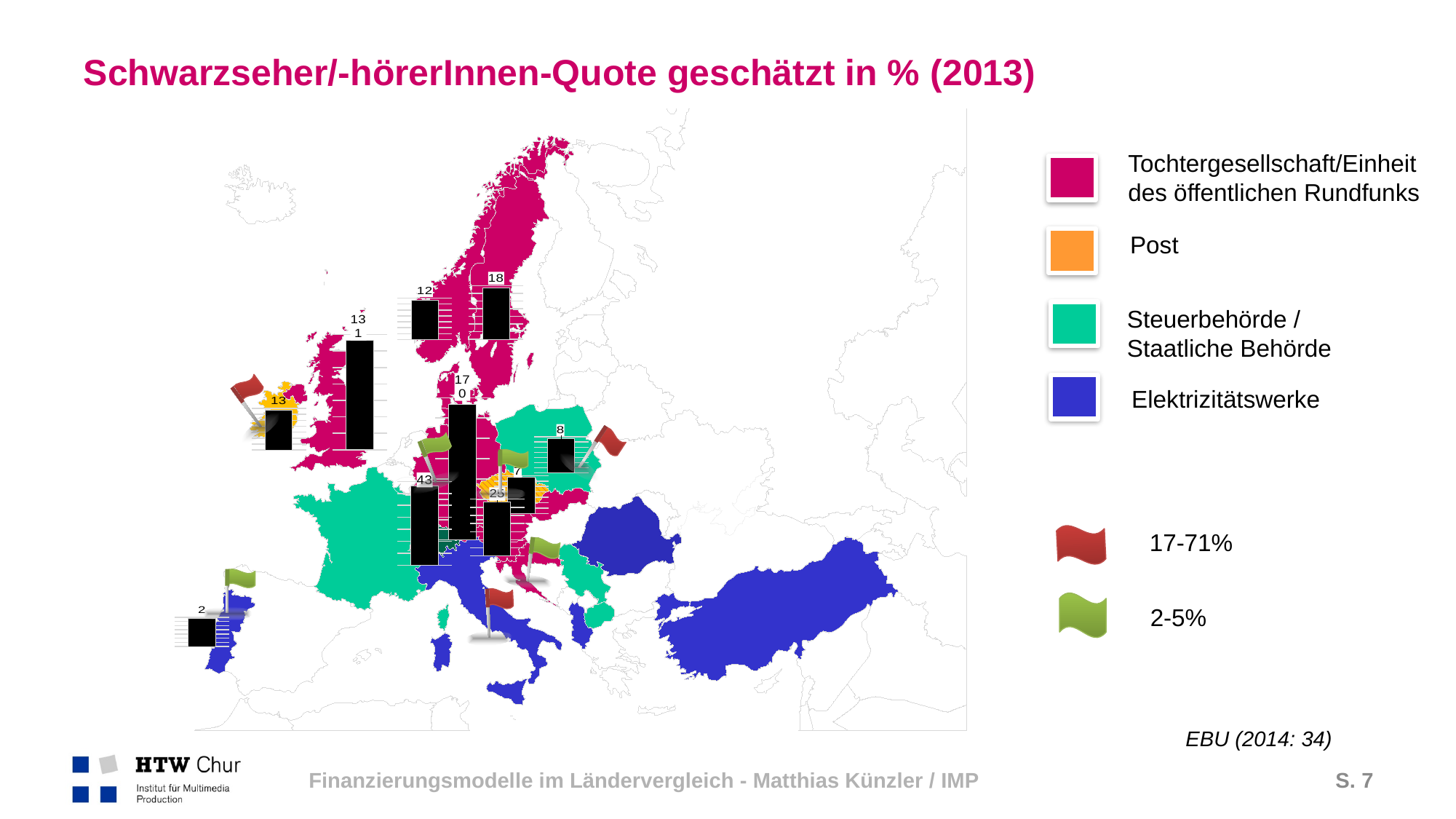
What percentage range does the red flag represent in the legend? 17-71% What kind of chart is overlaid on the countries of the map? Bar chart What value is shown on the bar over Austria? 25 What value is shown on the bar over Portugal? 2 What value is shown on the bar over Sweden? 18 What is the title of the chart on the slide? Schwarzseher/-hörerInnen-Quote geschätzt in % (2013) What value is shown on the bar over Poland? 8 What value is shown on the bar over France? 43 What is the difference between the value for France and the value for Austria? 18 According to the legend, which colour represents 'Post'? Orange Which is larger, the value for Sweden or the value for Norway? Sweden What value is shown on the bar over Norway? 12